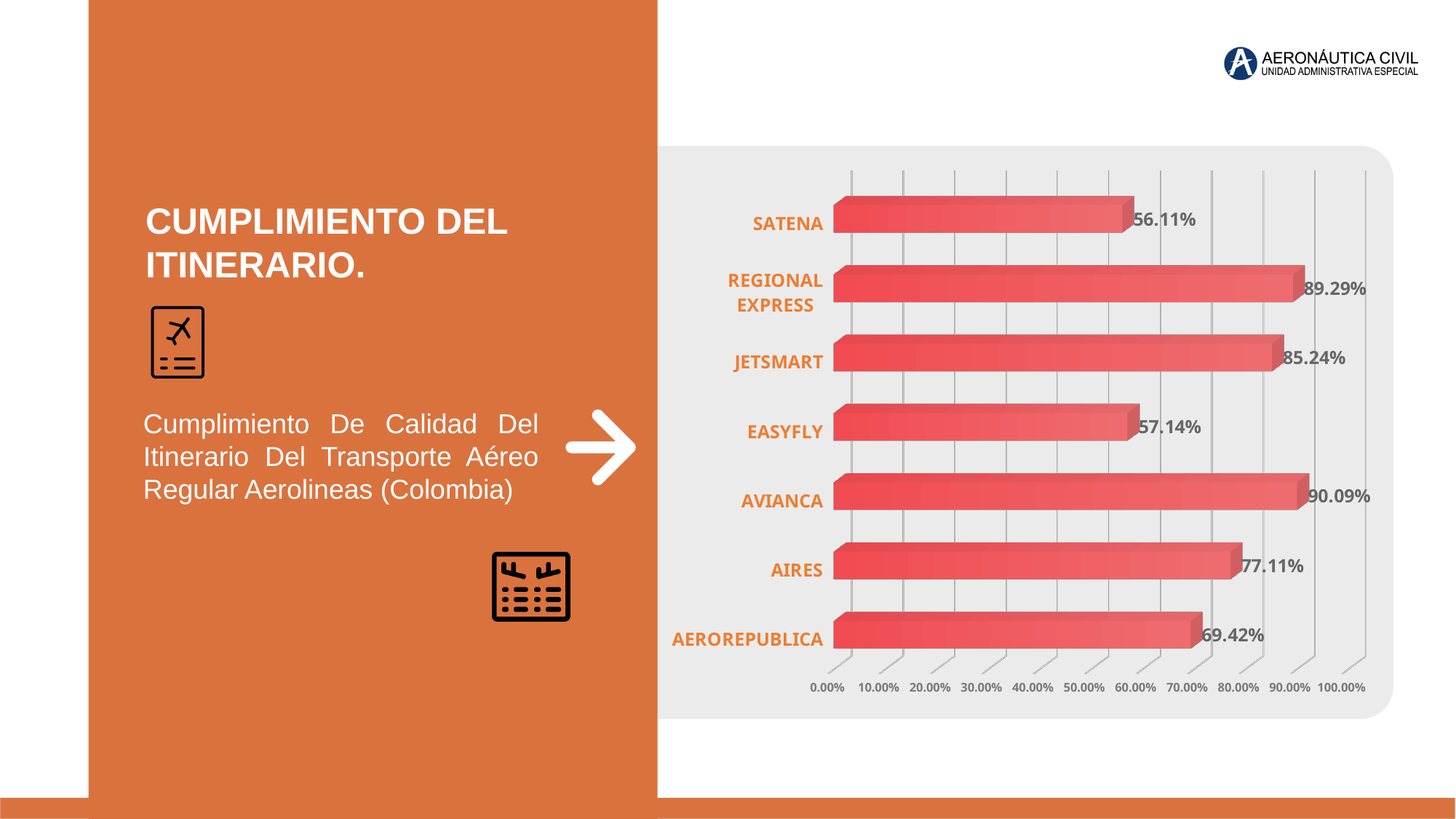
What is the value for AEROREPUBLICA? 69.42% What is the difference between the values for AIRES and AEROREPUBLICA? 7.69% What is the maximum value shown on the horizontal axis? 100.00% What is the value for REGIONAL EXPRESS? 89.29% What kind of chart is shown on the slide? bar chart Which airline has the highest value? AVIANCA What is the value for AVIANCA? 90.09% How many airlines are shown in the chart? 7 Is the value for AIRES greater or less than 70.00%? greater Which airline has the lowest value? SATENA What is the value for SATENA? 56.11% Which is larger, the value for JETSMART or the value for EASYFLY? JETSMART